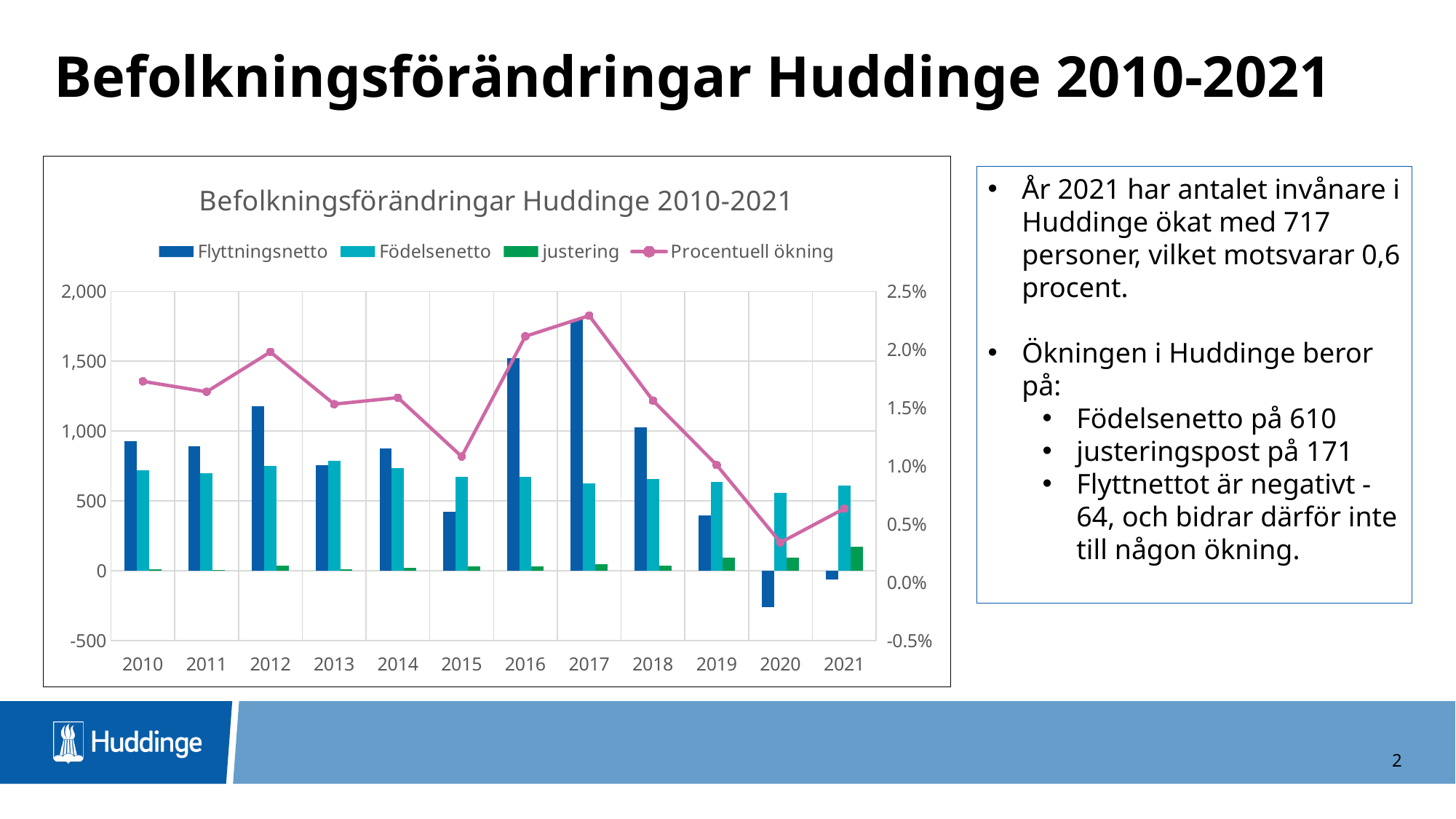
In which year is Procentuell ökning lowest? 2020 In which year is justering highest? 2021 In which year is Flyttningsnetto highest? 2017 Is the value for Procentuell ökning in 2020 greater or less than 0.5%? less How many series does the chart legend list? 4 Is the value for Flyttningsnetto in 2017 greater or less than 1,500? greater How many years are shown on the x axis of the chart? 12 In which year is Flyttningsnetto lowest? 2020 Which is larger, Flyttningsnetto in 2012 or Flyttningsnetto in 2013? 2012 In which year is Procentuell ökning highest? 2017 What kind of chart is shown on the slide? Combined bar and line chart Does Procentuell ökning rise or fall from 2017 to 2020? fall